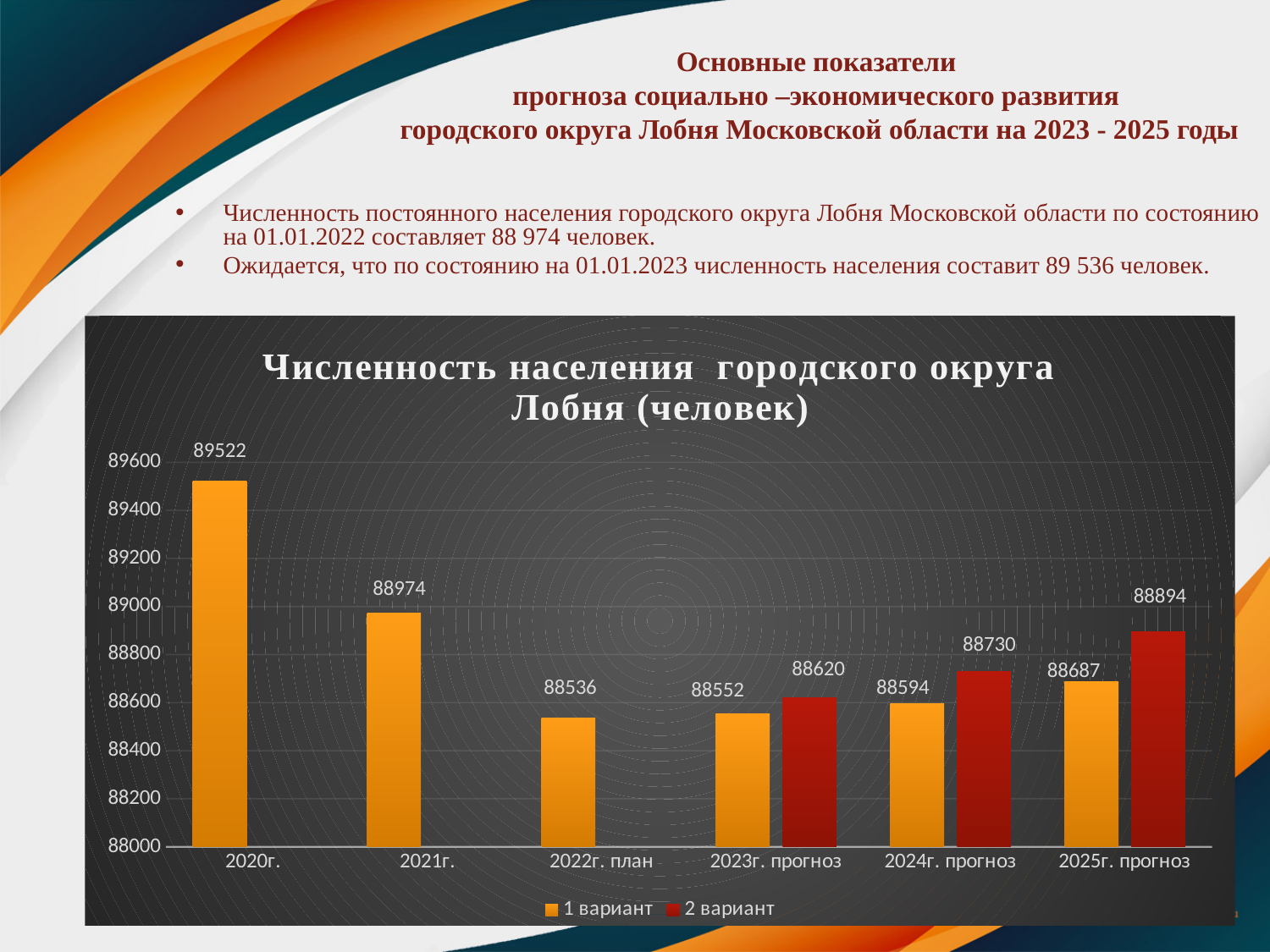
What is the value of the 1 вариант series for 2024г. прогноз? 88594 Which category has the lowest value in the 1 вариант series? 2022г. план What is the value of the 2 вариант series for 2025г. прогноз? 88894 How many series does the legend list? 2 How many categories are shown on the x axis? 6 What is the difference between the values for 2020г. and 2021г.? 548 What is the difference between the 2 вариант and 1 вариант values for 2023г. прогноз? 68 Which category has the highest value in the 1 вариант series? 2020г. What kind of chart is shown on the slide? Bar chart For 2024г. прогноз, which series has the larger value, 1 вариант or 2 вариант? 2 вариант What is the title of the chart? Численность населения городского округа Лобня (человек) What is the value for 2020г. in the chart? 89522